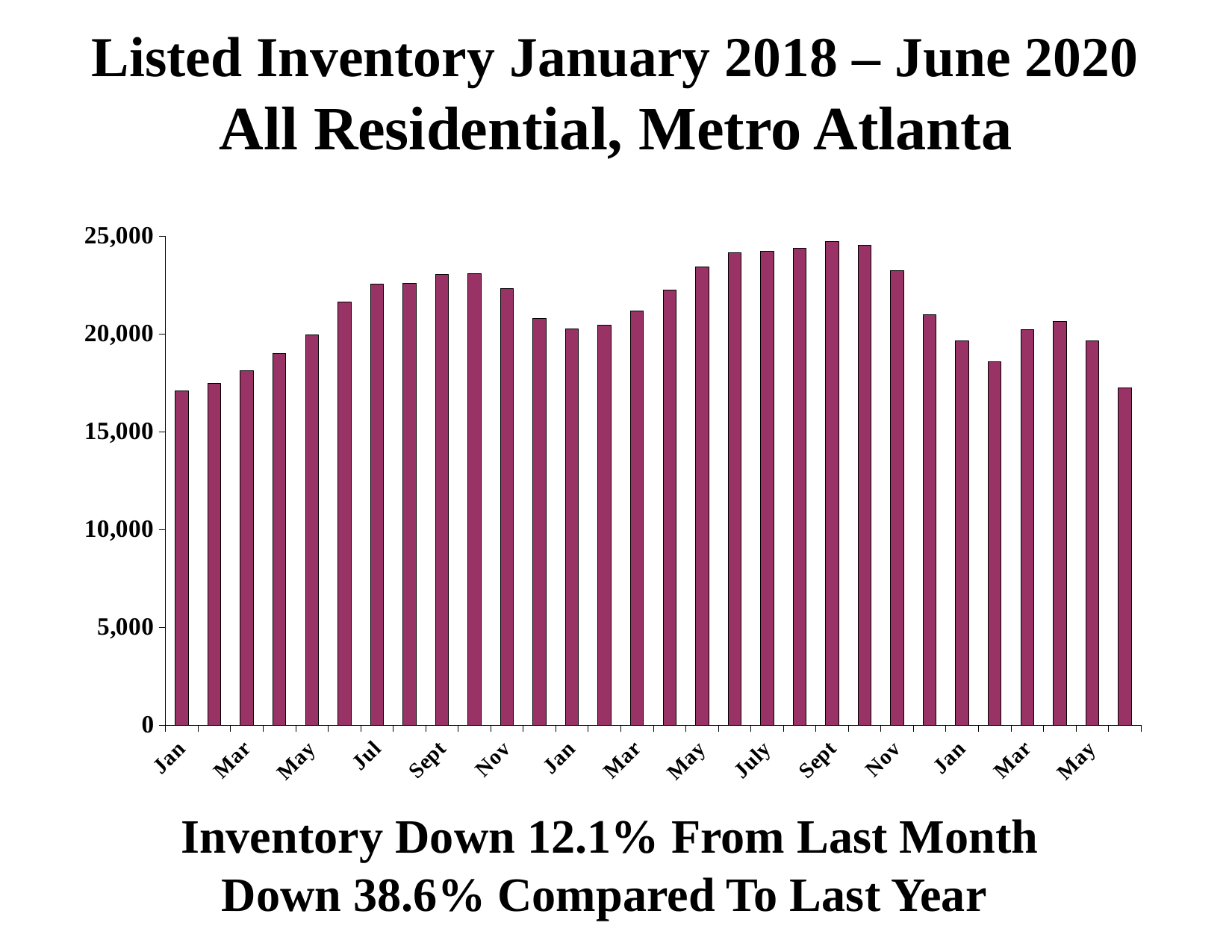
Do the values rise or fall from Sept 2019 to Jan 2020? fall Which is larger, the value for Jul 2018 or the value for Jan 2020? Jul 2018 Is the value for the Mar 2018 bar greater or less than 20,000? less What kind of chart is shown on the slide? bar chart What is the title of the chart? Listed Inventory January 2018 – June 2020 All Residential, Metro Atlanta Do the values rise or fall from Jan 2018 to Sept 2018? rise Is the value for the Jul 2018 bar greater or less than 20,000? greater How many bars (months) are plotted in the chart? 30 Is the value for the first Jan bar (January 2018) greater or less than 20,000? less Which is larger, the value for Sept 2019 or the value for Jan 2018? Sept 2019